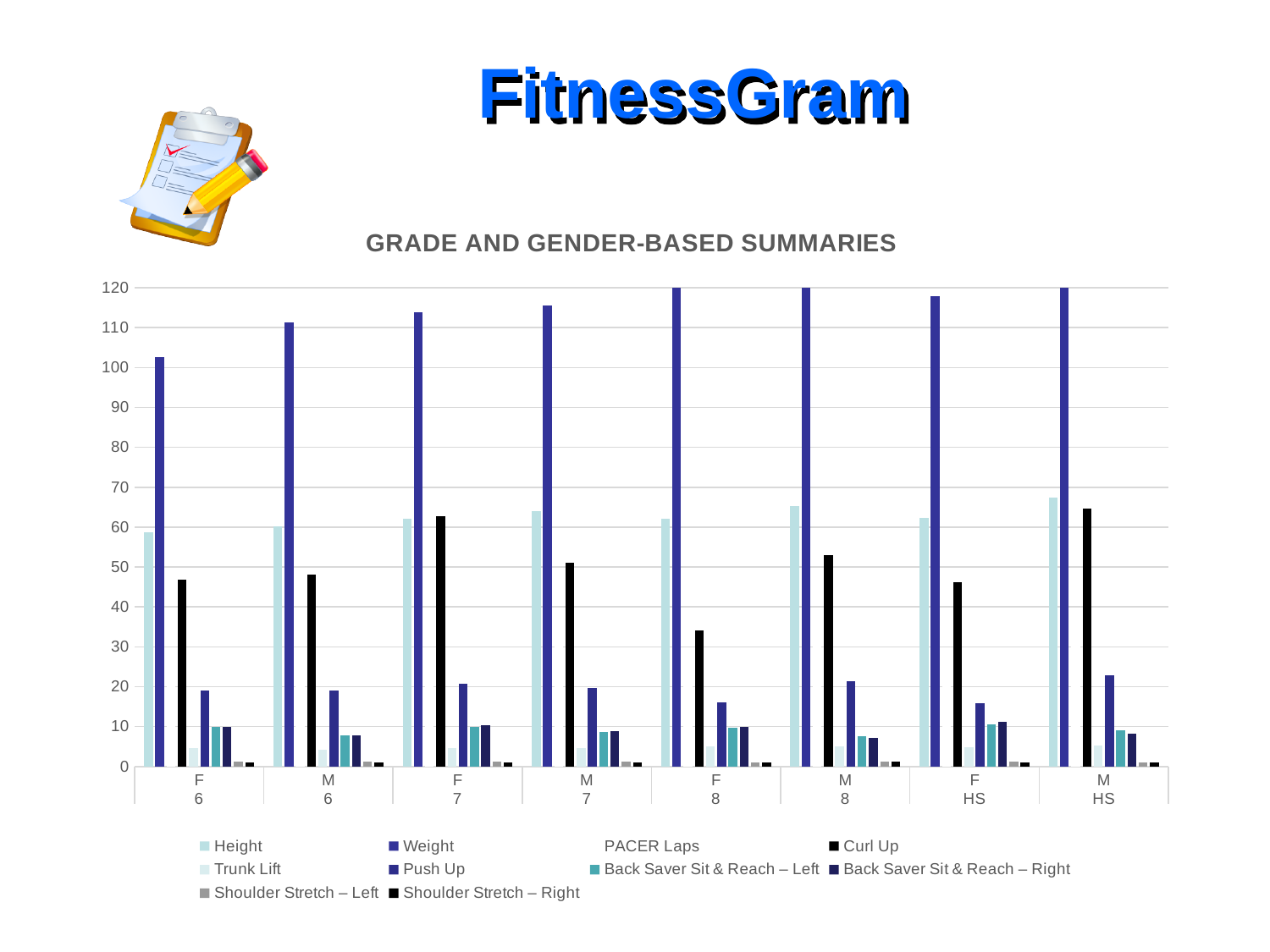
Is the Curl Up value for F 7 greater or less than 60? greater Which is larger, the Weight value for F 6 or for M 6? M 6 What is the title of the chart? GRADE AND GENDER-BASED SUMMARIES Which category has the lowest Curl Up bar? F 8 How many series does the legend list? 10 How many grade/gender categories are shown on the x axis? 8 What kind of chart is shown on the slide? bar chart Which is larger, the Curl Up value for F 7 or for F 8? F 7 Is the Weight value for F 6 greater or less than 110? less Is the Curl Up value for F 8 greater or less than 40? less Which category has the lowest Weight bar? F 6